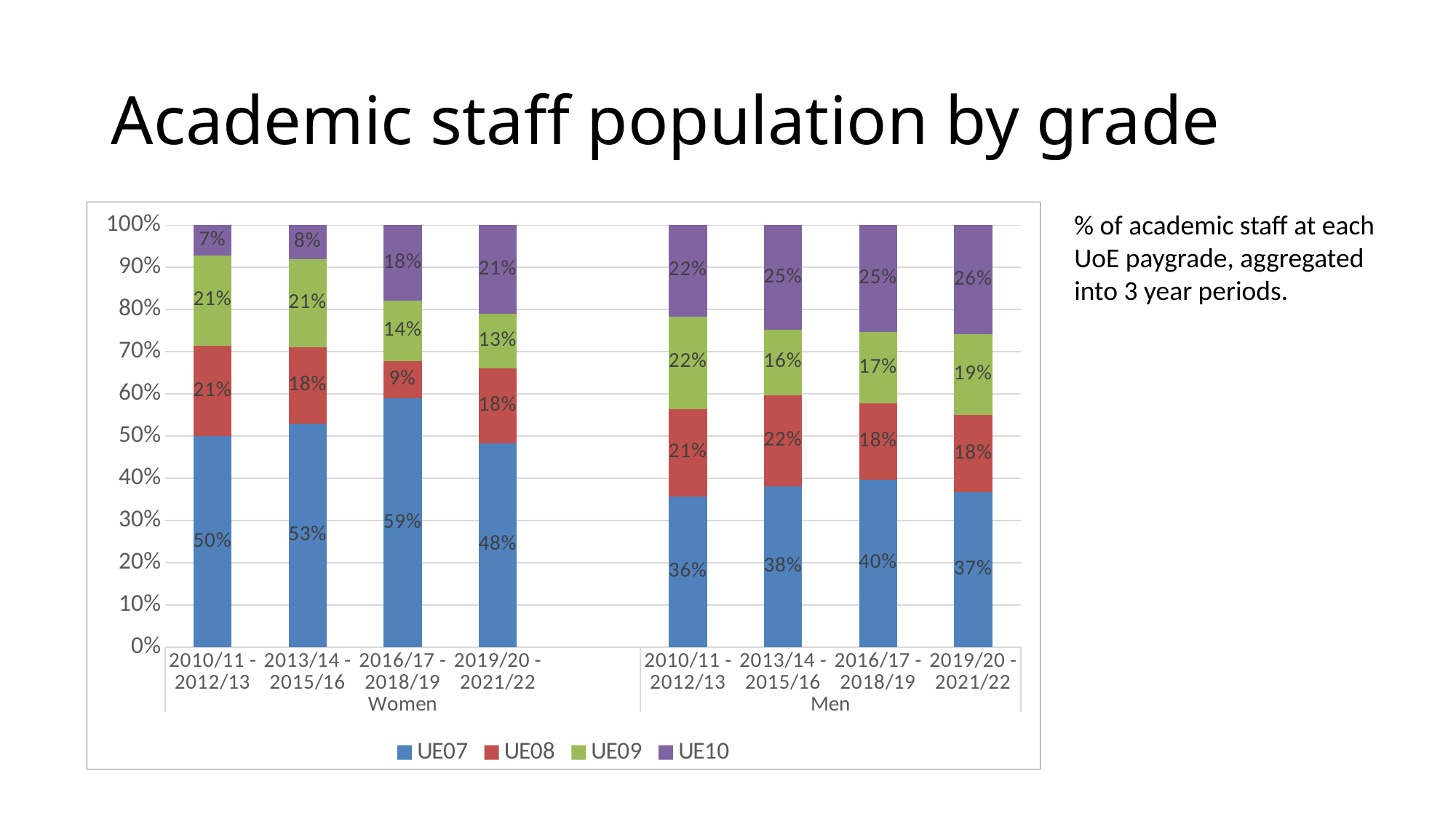
What is the difference between the UE07 value for Women and for Men in 2010/11 - 2012/13? 14% What is the UE10 value for Men in 2019/20 - 2021/22? 26% Which is larger: the UE10 value for Women in 2019/20 - 2021/22 or the UE10 value for Men in 2019/20 - 2021/22? Men in 2019/20 - 2021/22 How many bars are plotted in the chart? 8 What is the UE08 value for Women in 2016/17 - 2018/19? 9% How many series does the legend list? 4 Across the four Men periods, does the UE10 value generally rise or fall over time? Rise What is the UE07 value for Women in 2016/17 - 2018/19? 59% What kind of chart is shown on the slide? Stacked bar chart Among the Women bars, which period has the highest UE07 value? 2016/17 - 2018/19 Among the Women bars, which period has the lowest UE10 value? 2010/11 - 2012/13 Which colour represents UE09 in the legend? Green